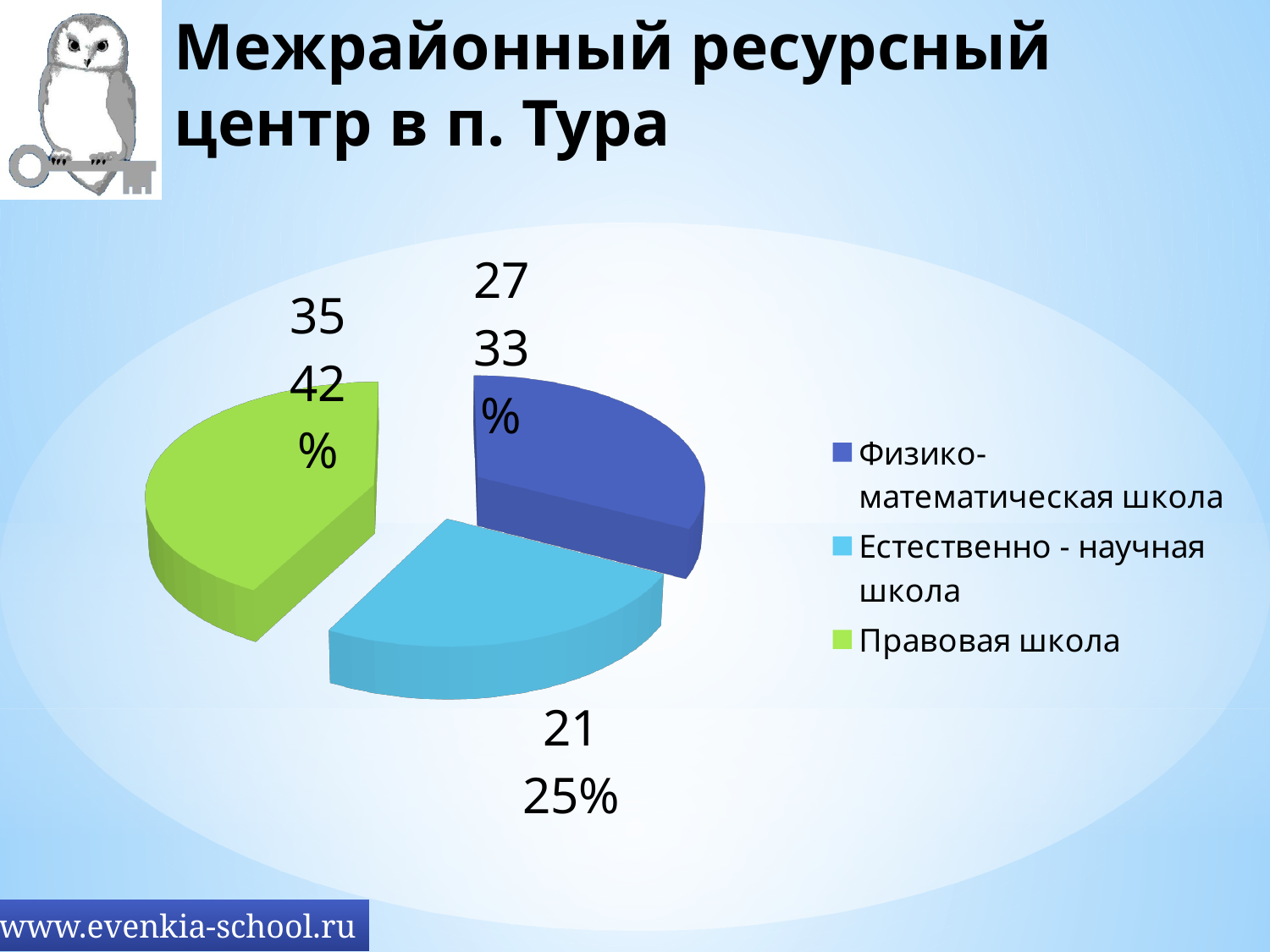
Which category has the largest slice? Правовая школа What kind of chart is shown on the slide? pie chart How many entries does the legend list? 3 What share of the pie does Естественно - научная школа have? 25% Which colour represents Правовая школа in the pie chart? green What share of the pie does Правовая школа have? 42% What is the value for Физико-математическая школа? 27 What is the value for Естественно - научная школа? 21 How many slices does the pie chart have? 3 What is the difference between the values for Правовая школа and Естественно - научная школа? 14 What is the value for Правовая школа? 35 Which category has the smallest slice? Естественно - научная школа